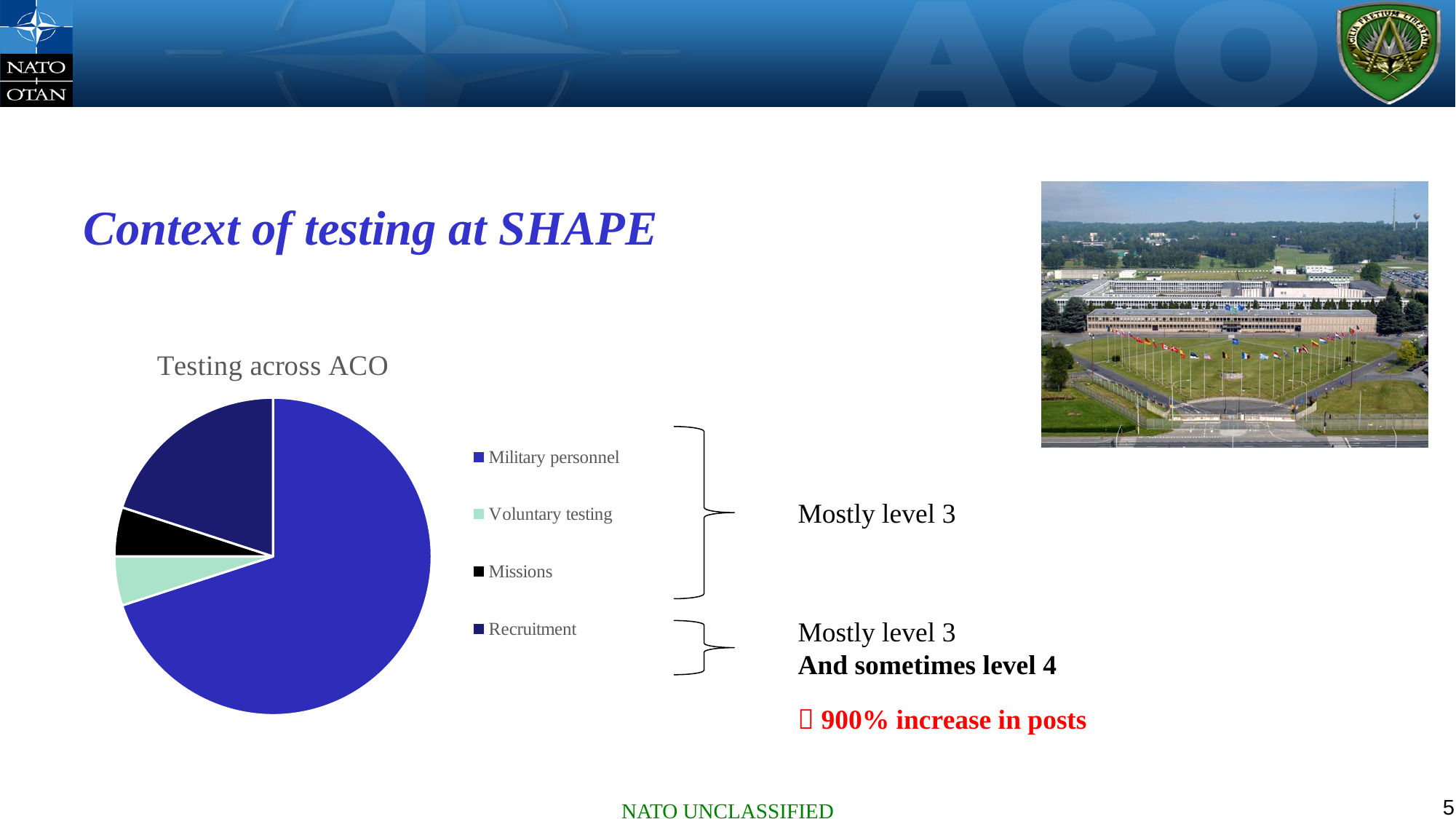
Which slice is larger, Military personnel or Recruitment? Military personnel Which category is the second largest slice of the pie? Recruitment Which category is shown in black in the pie chart? Missions What kind of chart is shown on the slide? Pie chart Which slice is larger, Recruitment or Missions? Recruitment Which category has the largest slice of the pie? Military personnel How many categories does the pie chart show? 4 What is the title of the chart? Testing across ACO Which slice is larger, Recruitment or Voluntary testing? Recruitment